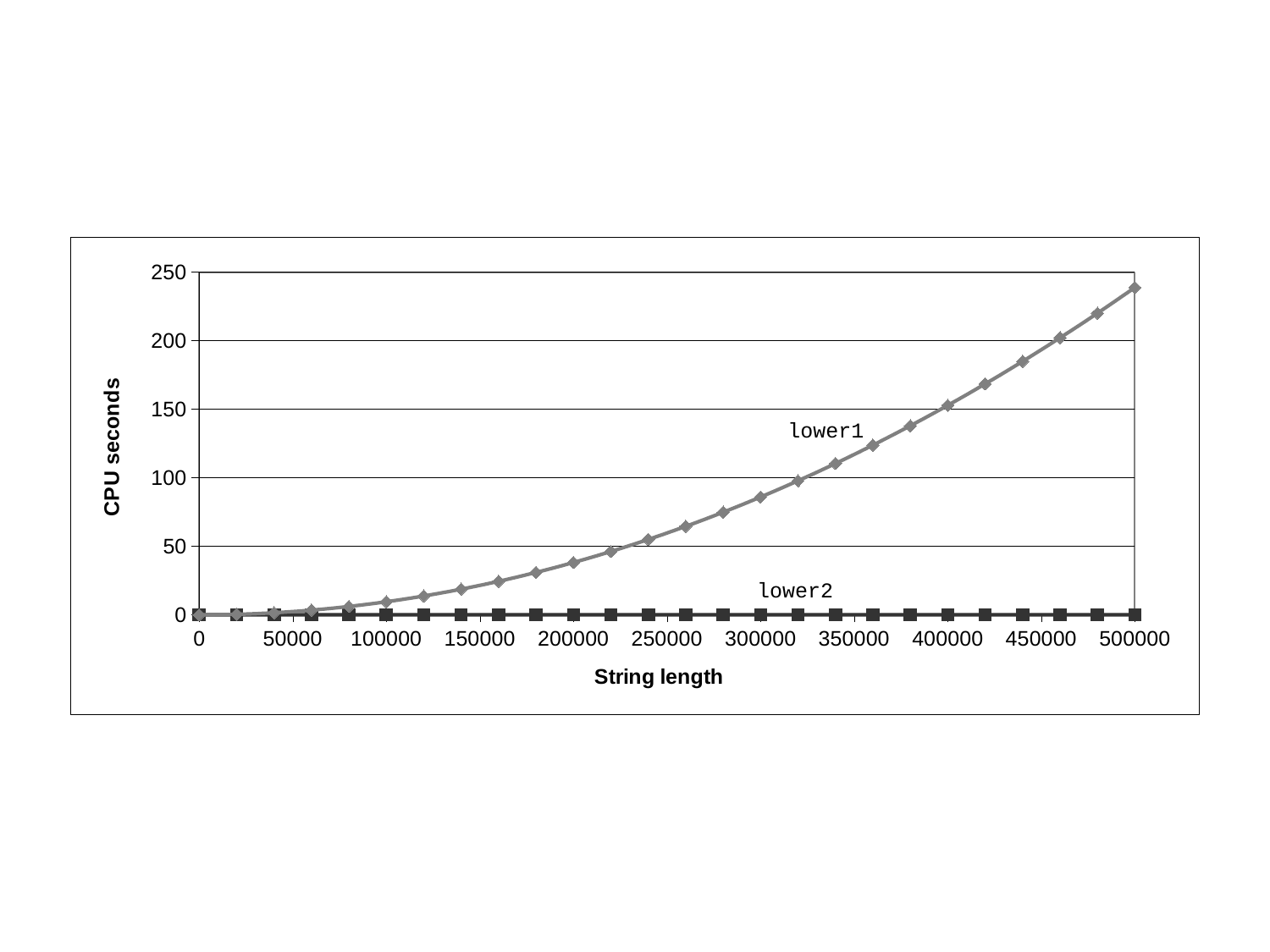
Which series stays lowest across all string lengths? lower2 Is the CPU seconds value for lower2 at a string length of 500000 greater or less than 50? less What is the title of the x axis? String length At a string length of 500000, which series has the larger CPU seconds value, lower1 or lower2? lower1 What is the title of the y axis? CPU seconds Which series reaches the highest CPU seconds value on the chart? lower1 Is the CPU seconds value for lower1 at a string length of 200000 greater or less than 50? less Is the CPU seconds value for lower1 at a string length of 300000 greater or less than 100? less What kind of chart is shown on the slide? line chart How many series are plotted on the chart? 2 Does the CPU seconds value for lower1 rise or fall as string length increases? rise